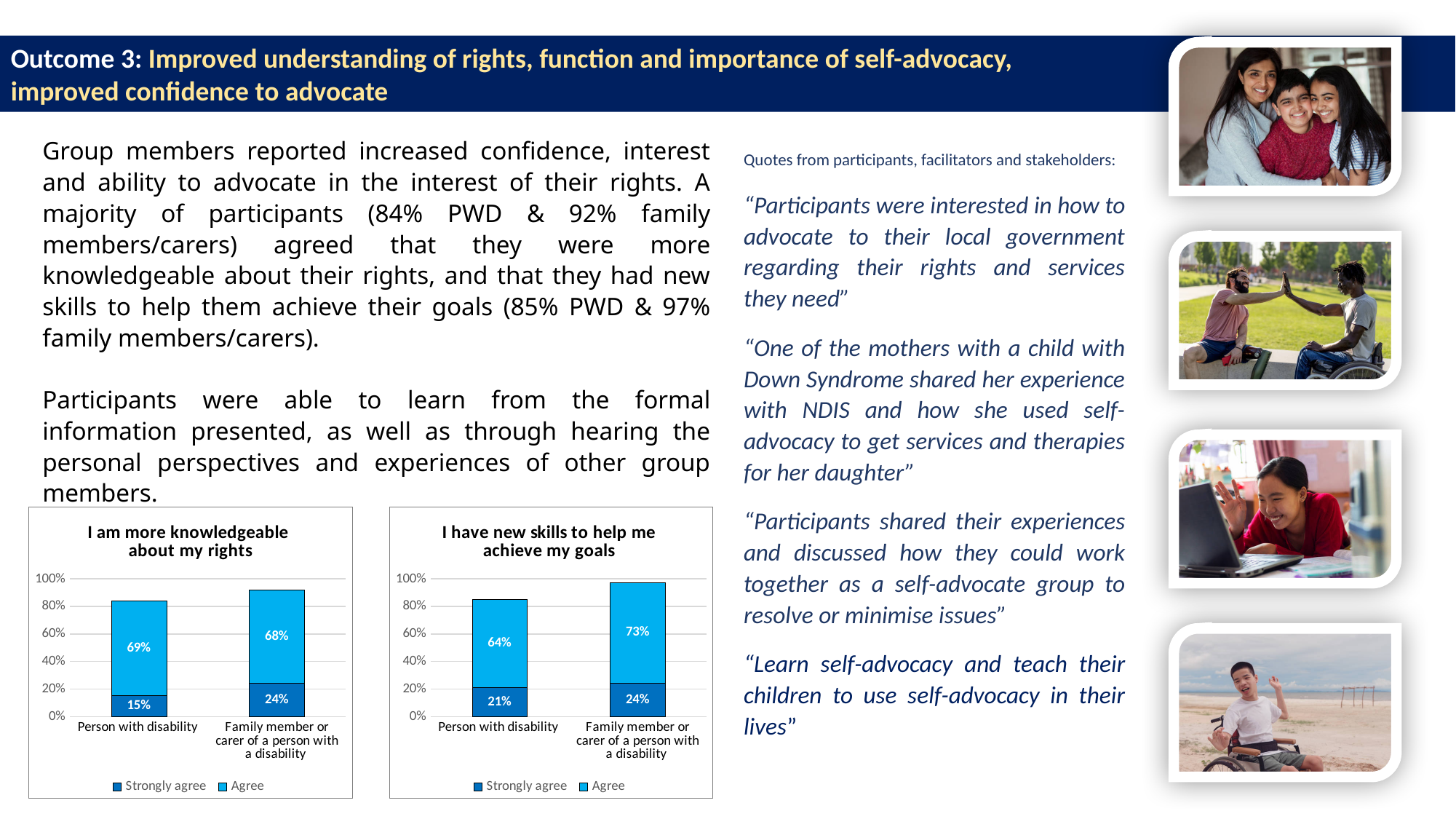
In the chart titled "I have new skills to help me achieve my goals", what is the Strongly agree value for Person with disability? 21% In the chart titled "I have new skills to help me achieve my goals", what is the total of the stacked bar for Family member or carer of a person with a disability? 97% In the chart titled "I am more knowledgeable about my rights", what is the Agree value for Person with disability? 69% How many categories are shown on the x axis of the chart titled "I have new skills to help me achieve my goals"? 2 In the chart titled "I am more knowledgeable about my rights", what is the Strongly agree value for Family member or carer of a person with a disability? 24% In the chart titled "I am more knowledgeable about my rights", what is the total of the stacked bar for Person with disability? 84% In the chart titled "I have new skills to help me achieve my goals", what is the Agree value for Family member or carer of a person with a disability? 73% In the chart titled "I have new skills to help me achieve my goals", which category has the higher Agree value? Family member or carer of a person with a disability How many series does the legend list in the chart titled "I have new skills to help me achieve my goals"? 2 What kind of chart is the chart titled "I am more knowledgeable about my rights"? Stacked bar chart In the chart titled "I am more knowledgeable about my rights", which category has the lowest Strongly agree value? Person with disability In the chart titled "I am more knowledgeable about my rights", what is the difference between the Strongly agree values for Family member or carer and Person with disability? 9%